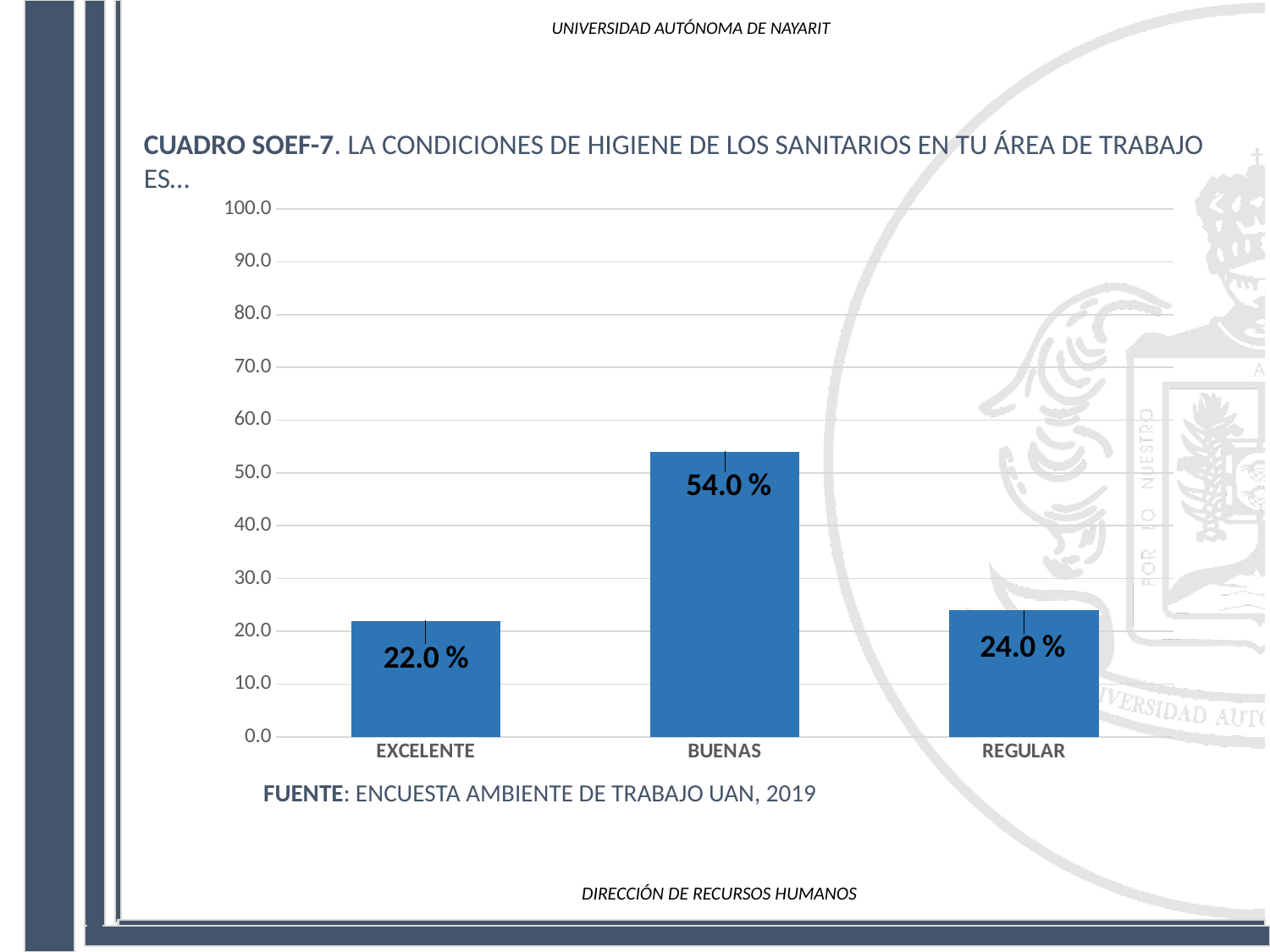
Which category has the highest value? BUENAS What is the difference between the values for REGULAR and EXCELENTE? 2.0 % What is the value for REGULAR? 24.0 % Which category has the lowest value? EXCELENTE What is the value for EXCELENTE? 22.0 % How many categories are shown on the x axis? 3 Is the value for BUENAS greater or less than 50.0? greater Which is larger, the value for BUENAS or the value for EXCELENTE? BUENAS What is the value for BUENAS? 54.0 % What source is cited below the chart? ENCUESTA AMBIENTE DE TRABAJO UAN, 2019 What kind of chart is shown on the slide? bar chart What is the difference between the values for BUENAS and REGULAR? 30.0 %